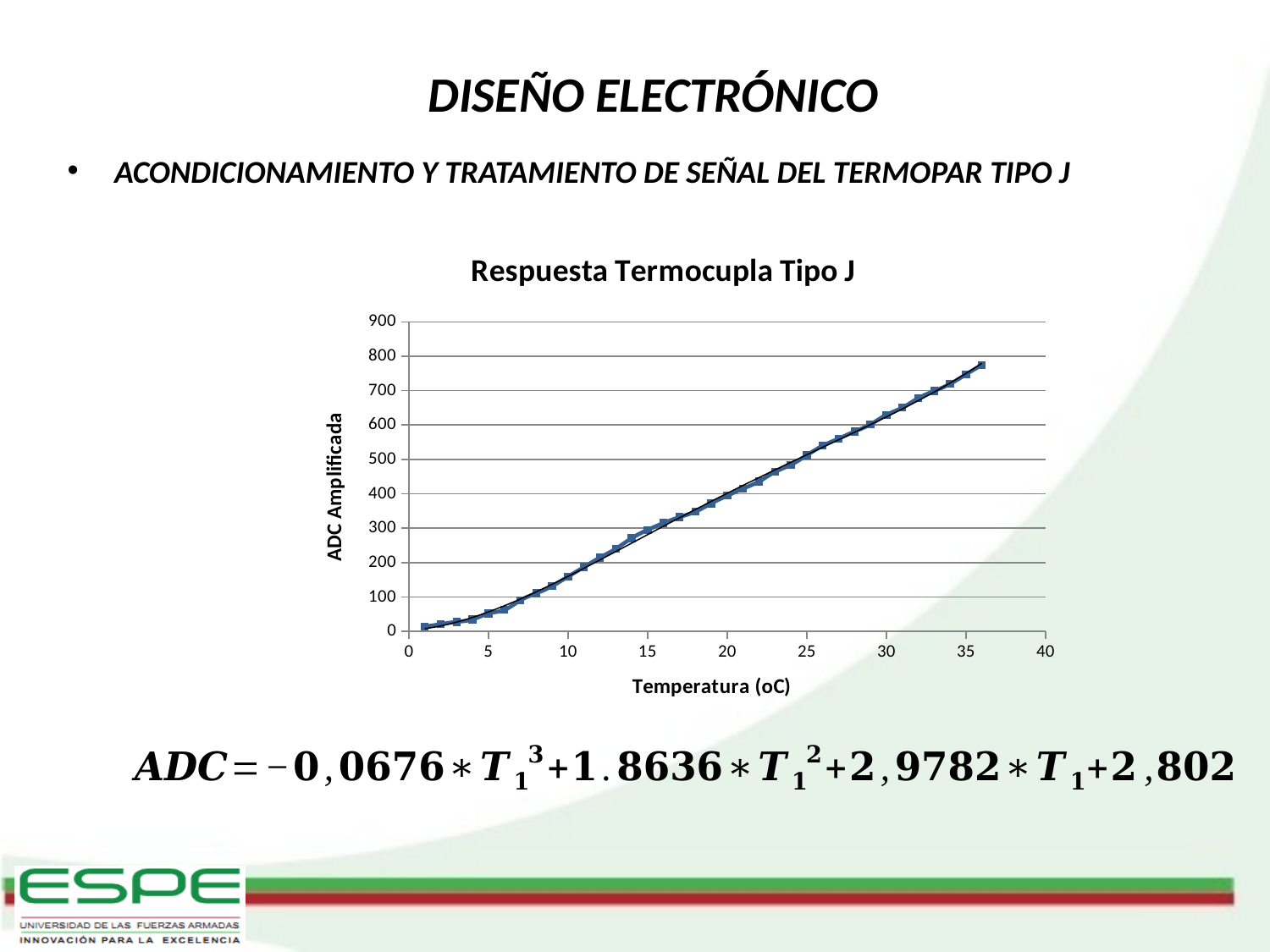
Which has the larger ADC Amplificada value, the point at 15 oC or the point at 25 oC? 25 oC Is the ADC Amplificada value at 20 oC greater or less than 300? greater At which end of the temperature range is the ADC Amplificada value highest, the lowest temperature or the highest temperature? the highest temperature Is the ADC Amplificada value at 25 oC greater or less than 600? less Is the ADC Amplificada value at 5 oC greater or less than 100? less What kind of chart is shown on the slide? line chart What is the label of the vertical axis of the chart? ADC Amplificada What is the title of the chart? Respuesta Termocupla Tipo J Do the ADC Amplificada values rise or fall as Temperatura increases along the x axis? rise